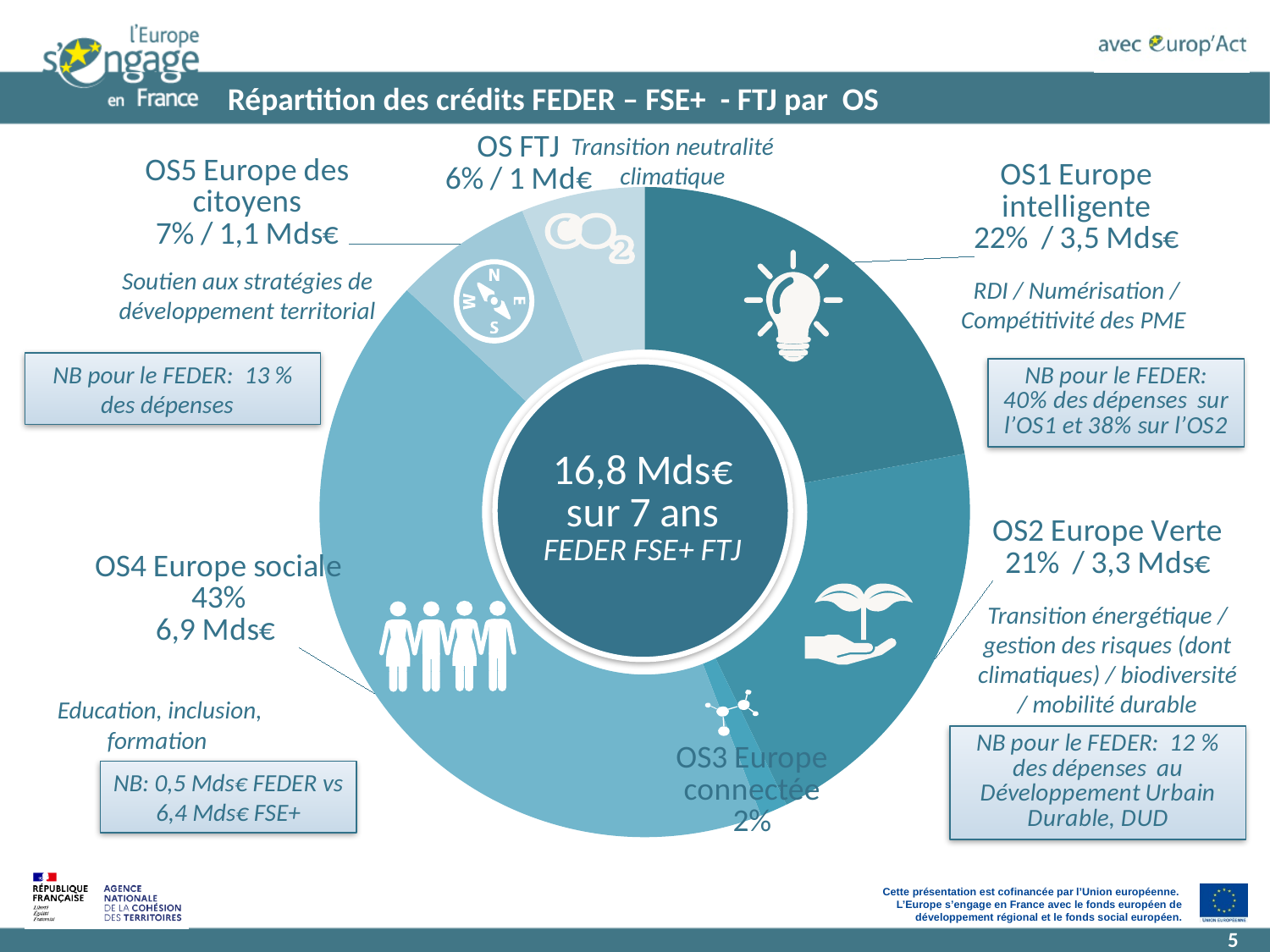
What is the difference in percentage points between OS1 Europe intelligente and OS2 Europe Verte? 1 What amount in Mds€ is allocated to OS2 Europe Verte? 3,3 Mds€ What total amount is shown in the centre of the pie chart? 16,8 Mds€ Which OS receives the smallest share of the credits? OS3 Europe connectée What share of the credits goes to OS3 Europe connectée? 2% What amount is allocated to OS5 Europe des citoyens? 1,1 Mds€ What share of the credits goes to OS4 Europe sociale? 43% What share of the credits goes to OS1 Europe intelligente? 22% Which OS receives the largest share of the credits? OS4 Europe sociale What kind of chart is shown on the slide? doughnut chart Which has a larger share, OS5 Europe des citoyens or OS FTJ? OS5 Europe des citoyens How many segments does the pie chart have? 6